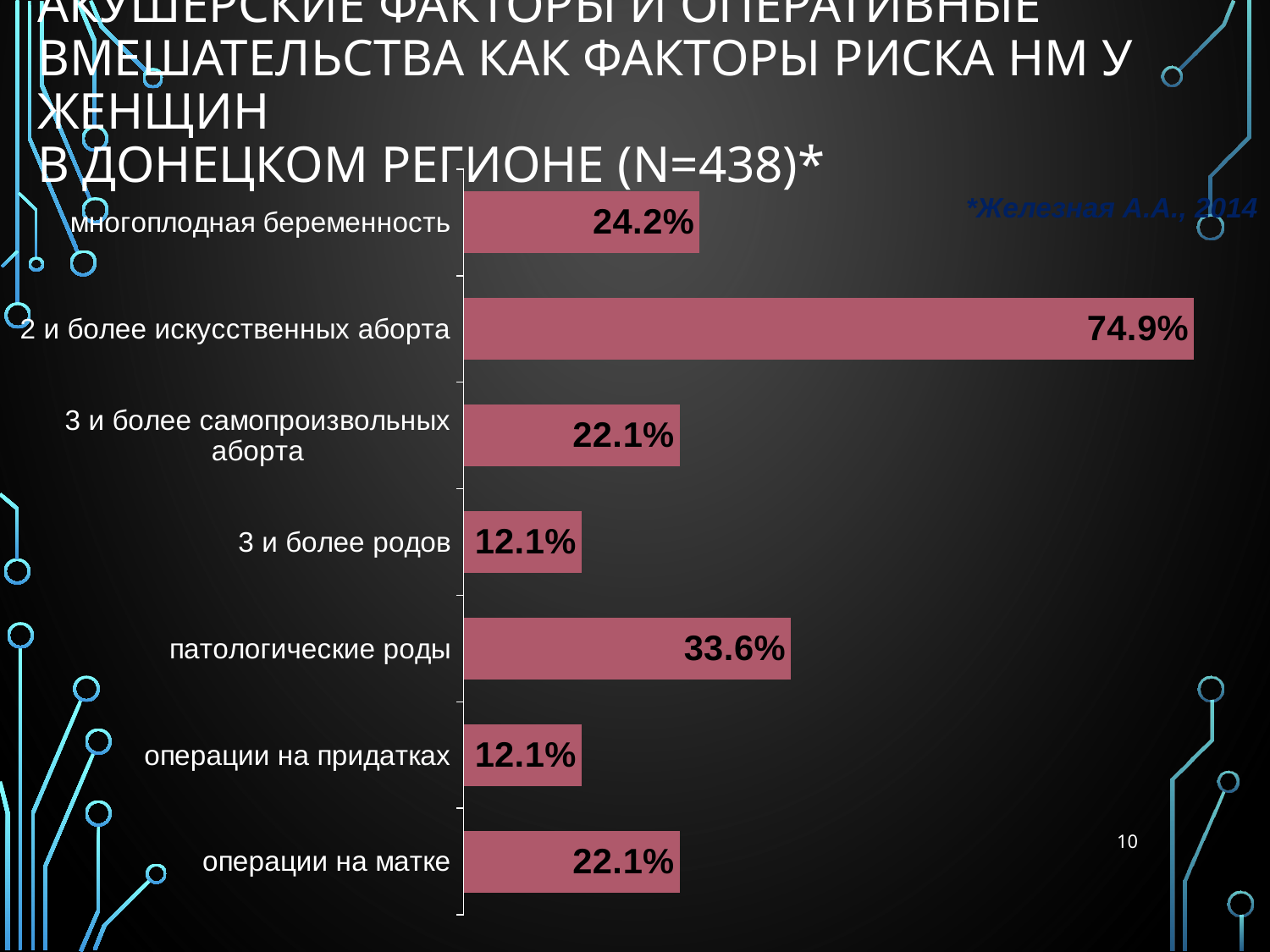
What is the difference between the values for «многоплодная беременность» and «3 и более родов»? 12.1% What is the value for «2 и более искусственных аборта»? 74.9% How many categories are shown in the chart? 7 What sample size (N) is stated in the slide title? 438 What is the difference between the values for «2 и более искусственных аборта» and «патологические роды»? 41.3% What is the value for «патологические роды»? 33.6% What is the value for «3 и более родов»? 12.1% Which is larger, the value for «патологические роды» or the value for «многоплодная беременность»? патологические роды What is the value for «многоплодная беременность»? 24.2% Which category has the highest value? 2 и более искусственных аборта What kind of chart is shown on the slide? bar chart What is the value for «операции на матке»? 22.1%